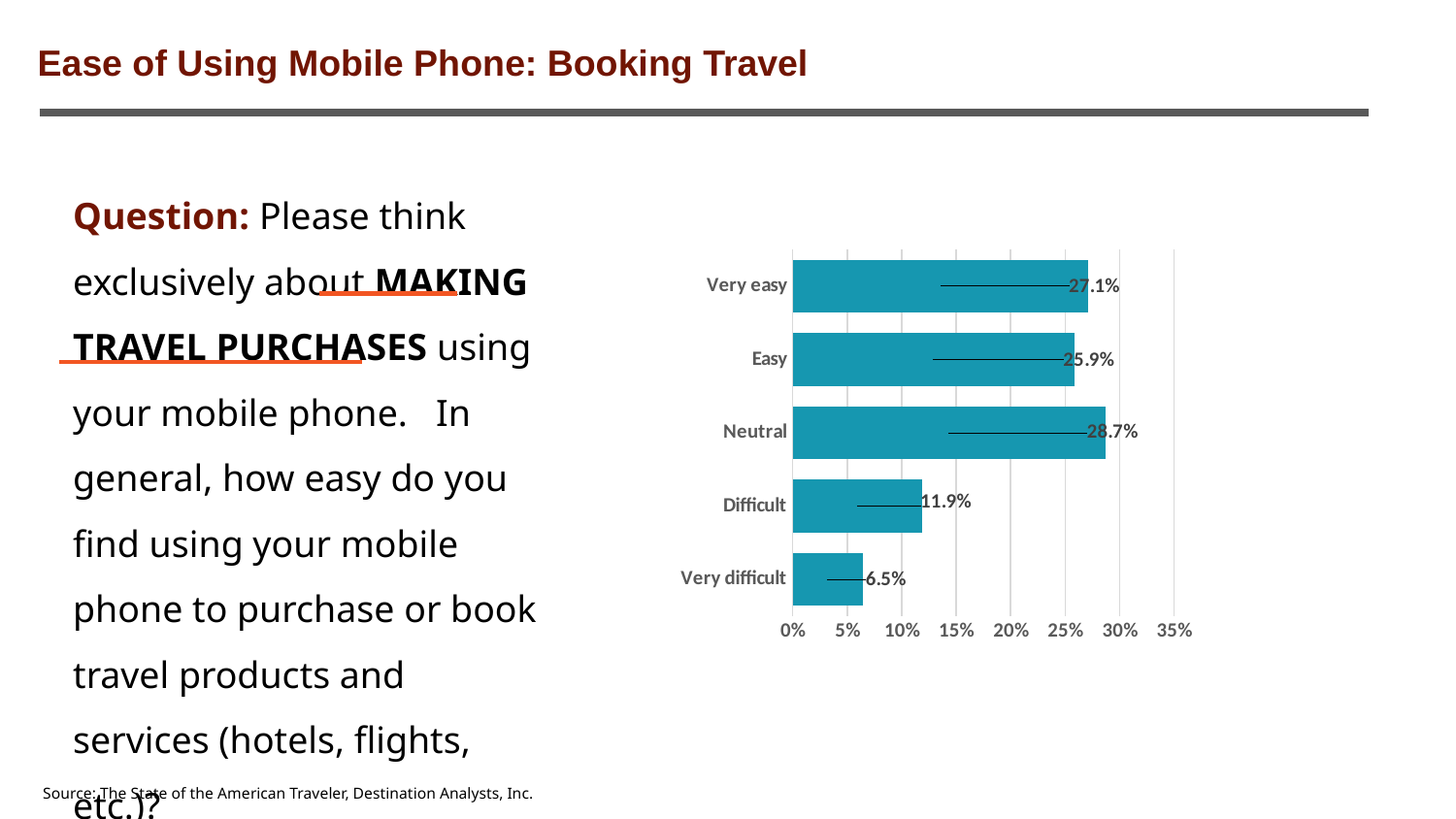
Is the value for Difficult greater or less than 10%? greater Which category has the highest value? Neutral What is the difference between the values for Neutral and Easy? 2.8% What kind of chart is shown on the slide? bar chart What is the value for Very difficult? 6.5% What is the title of the slide containing the chart? Ease of Using Mobile Phone: Booking Travel How many categories are shown in the chart? 5 Which is larger, the value for Very easy or the value for Difficult? Very easy What is the value for Neutral? 28.7% What is the value for Very easy? 27.1% What is the difference between the values for Difficult and Very difficult? 5.4% Which category has the lowest value? Very difficult